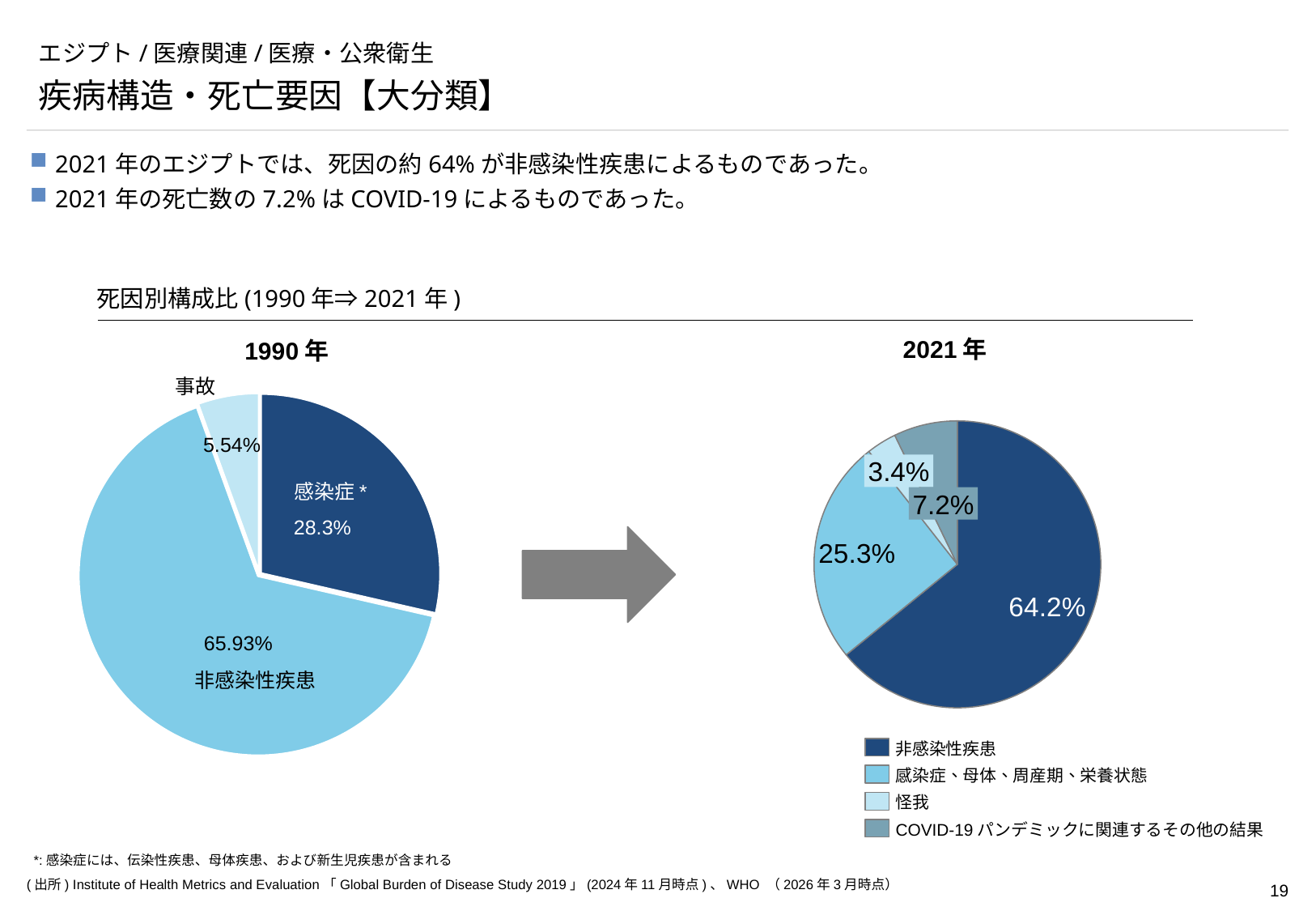
1990年の円グラフで、最も割合が小さい項目はどれですか？ 事故 2021年の円グラフで、感染症、母体、周産期、栄養状態とCOVID-19パンデミックに関連するその他の結果では、どちらの割合が大きいですか？ 感染症、母体、周産期、栄養状態 2021年の円グラフで、最も割合が大きい項目はどれですか？ 非感染性疾患 2021年の円グラフで、最も割合が小さい項目はどれですか？ 怪我 1990年の円グラフで、事故の割合はいくらですか？ 5.54% 2021年の円グラフの凡例には、いくつの項目が示されていますか？ 4 1990年の円グラフで、感染症*の割合はいくらですか？ 28.3% 2021年の円グラフで、怪我の割合はいくらですか？ 3.4% 2021年の円グラフで、非感染性疾患の割合はいくらですか？ 64.2% 2021年の円グラフで、COVID-19パンデミックに関連するその他の結果の割合はいくらですか？ 7.2% 1990年の円グラフで、非感染性疾患の割合はいくらですか？ 65.93% このスライドの「死因別構成比」に使われているグラフの種類は何ですか？ 円グラフ